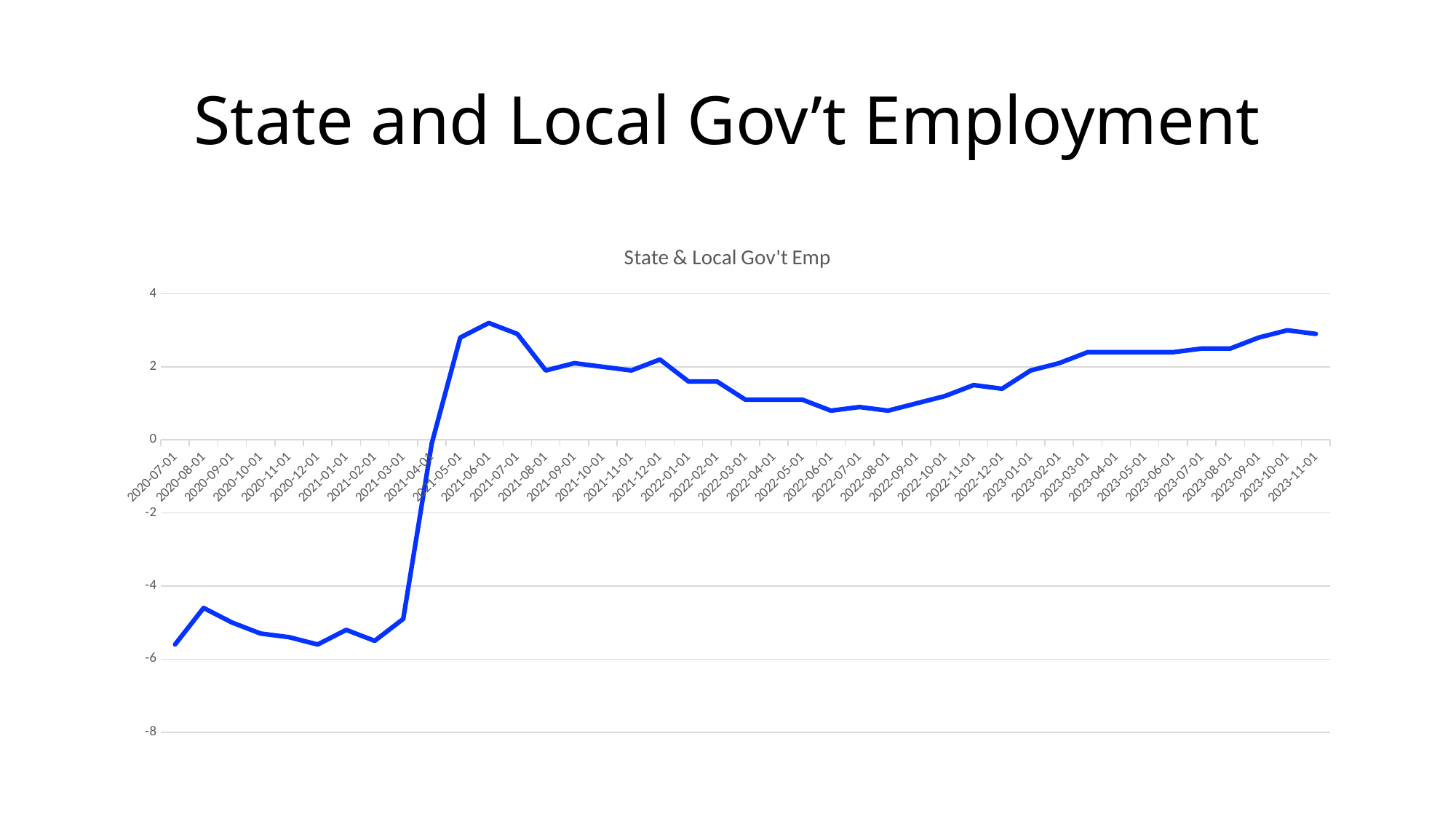
Is the value for 2020-07-01 greater or less than -4? less Is the value for 2021-06-01 greater or less than 2? greater What kind of chart is shown on the slide? line chart Which is larger, the value for 2020-08-01 or the value for 2021-08-01? 2021-08-01 What is the title shown above the chart? State & Local Gov't Emp Do the values generally rise or fall from 2022-08-01 to 2023-10-01? rise How many monthly data points are plotted on the chart? 41 Is the value for 2023-10-01 greater or less than 2? greater Which is larger, the value for 2021-06-01 or the value for 2022-06-01? 2021-06-01 Do the values generally rise or fall from 2021-06-01 to 2022-08-01? fall